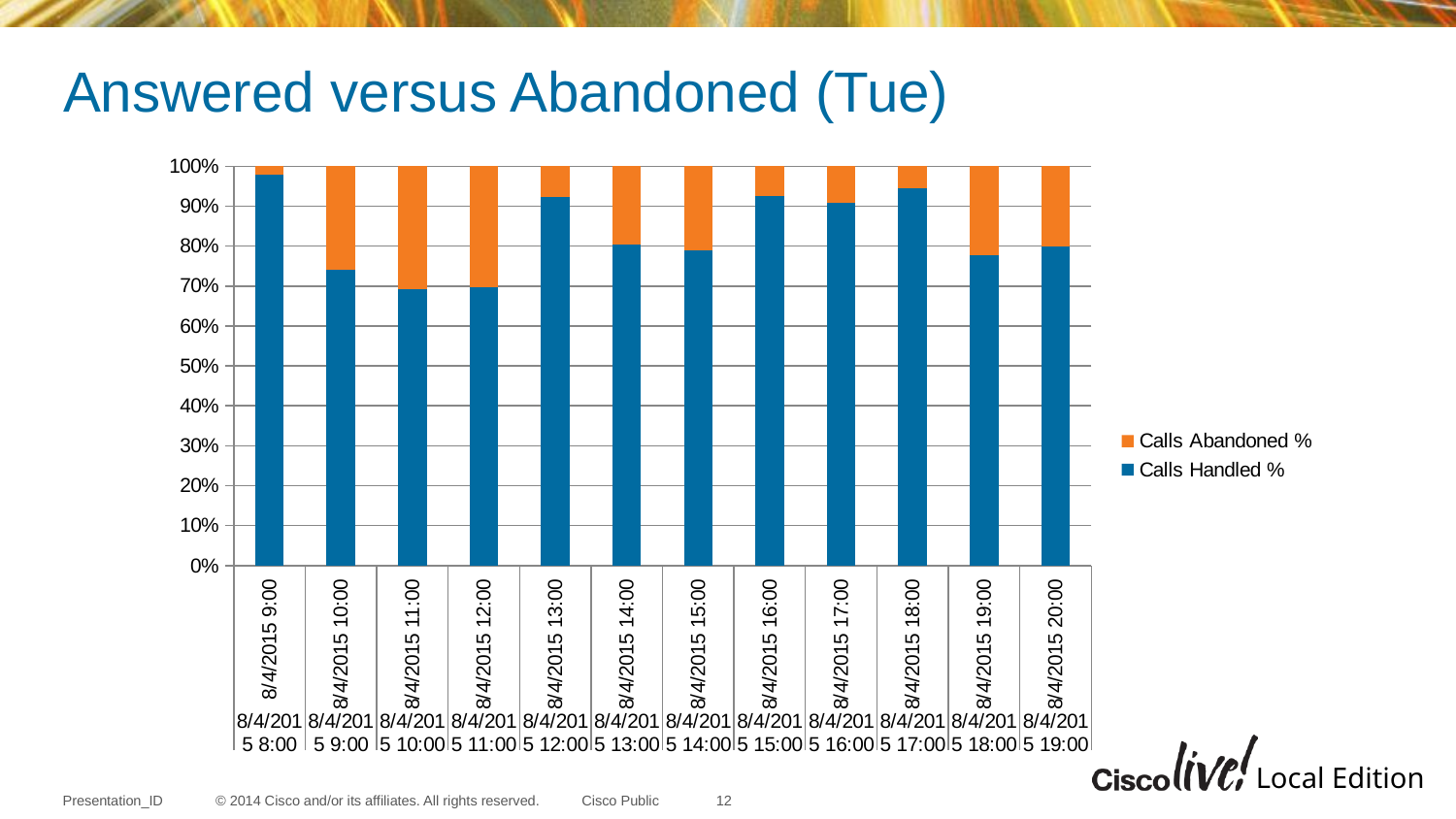
What is the title of the chart? Answered versus Abandoned (Tue) Is the Calls Handled % for the second bar (8/4/2015 10:00) greater or less than 70%? greater How many series does the legend list? 2 Is the Calls Handled % for the first bar (8/4/2015 9:00) greater or less than 90%? greater What does each stacked bar total? 100% What kind of chart is shown on the slide? Stacked bar chart Which series is shown in orange? Calls Abandoned % Which bar has the lowest Calls Abandoned %? 8/4/2015 9:00 (first bar) Which has a larger Calls Handled %, the bar labeled 8/4/2015 10:00 or the bar labeled 8/4/2015 13:00? 8/4/2015 13:00 Which bar has the highest Calls Handled %? 8/4/2015 9:00 (first bar) How many bars (time slots) are plotted in the chart? 12